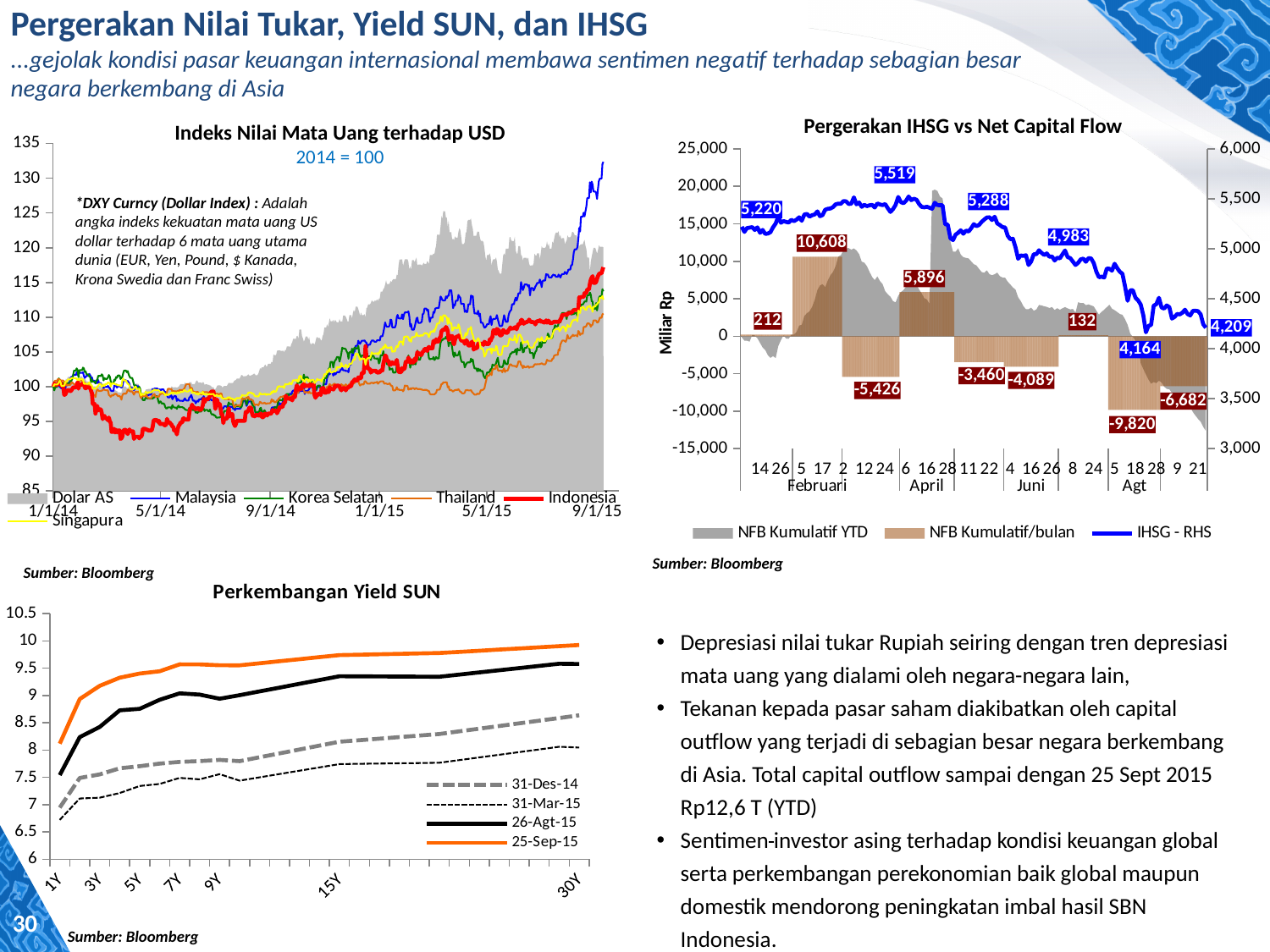
What are the legend entries of the 'Pergerakan IHSG vs Net Capital Flow' chart? NFB Kumulatif YTD, NFB Kumulatif/bulan, IHSG - RHS On the 'Perkembangan Yield SUN' chart, which series has the highest yields across the tenors? 25-Sep-15 On the 'Pergerakan IHSG vs Net Capital Flow' chart, what is the difference between the IHSG labels 5,519 and 4,209? 1,310 On the 'Pergerakan IHSG vs Net Capital Flow' chart, which is larger: the IHSG label 5,288 or 4,983? 5,288 How many series does the legend of the 'Perkembangan Yield SUN' chart list? 4 How many series does the legend of the 'Pergerakan IHSG vs Net Capital Flow' chart list? 3 On the 'Perkembangan Yield SUN' chart, is the 25-Sep-15 value at 30Y greater or less than 9.5? greater What kind of chart is 'Perkembangan Yield SUN'? Line chart On the 'Pergerakan IHSG vs Net Capital Flow' chart, what is the highest labelled IHSG value? 5,519 On the 'Pergerakan IHSG vs Net Capital Flow' chart, what is the lowest labelled monthly NFB value? -9,820 On the 'Pergerakan IHSG vs Net Capital Flow' chart, which monthly NFB bar has the highest labelled value? 10,608 On the 'Indeks Nilai Mata Uang terhadap USD' chart, is the Malaysia value at 9/1/15 greater or less than 125? greater